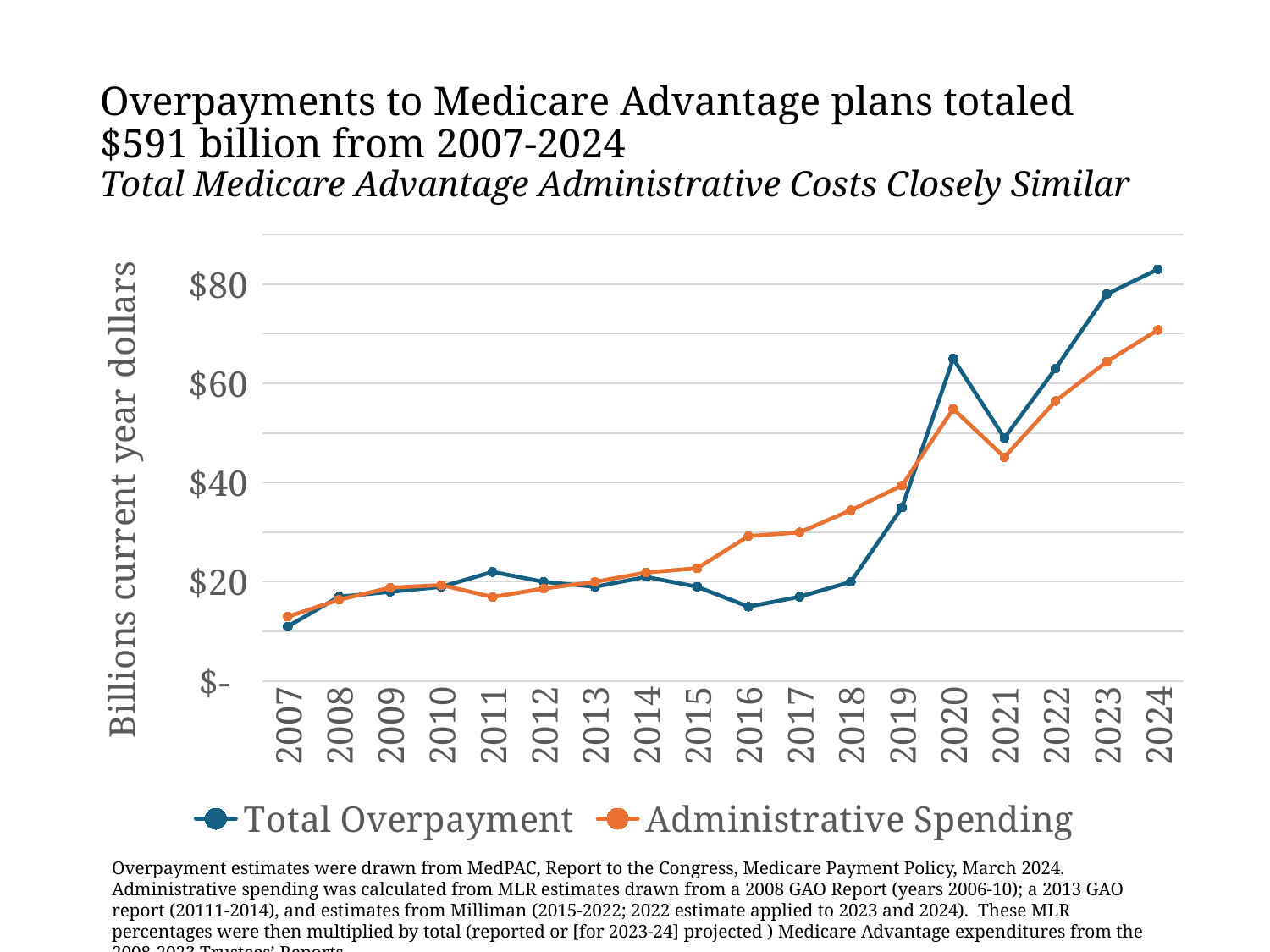
Is the value for Administrative Spending in 2024 greater or less than $80? less Is the value for Total Overpayment in 2016 greater or less than $20? less In 2016, which series is larger, Total Overpayment or Administrative Spending? Administrative Spending In which year is Total Overpayment highest? 2024 What kind of chart is shown on the slide? Line chart What is the label on the y axis? Billions current year dollars In which year is Total Overpayment lowest? 2007 How many series does the legend list? 2 How many years are plotted along the x axis? 18 In 2020, which series is larger, Total Overpayment or Administrative Spending? Total Overpayment Is the value for Total Overpayment in 2024 greater or less than $80? greater In which year is Administrative Spending highest? 2024